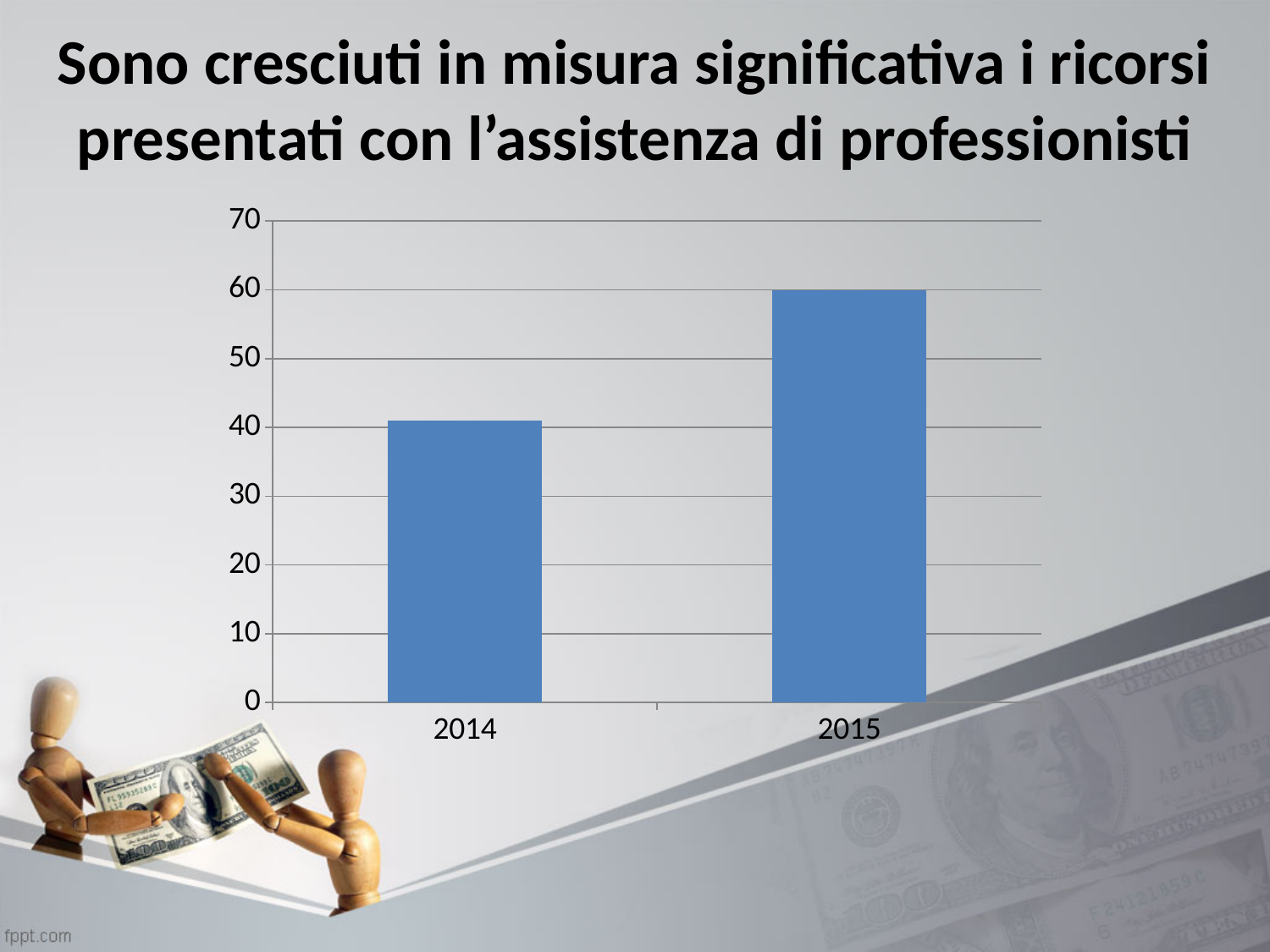
Which year has the lowest bar? 2014 Is the value for 2015 greater or less than 50? greater What is the value for 2015? 60 What is the title of the slide containing the chart? Sono cresciuti in misura significativa i ricorsi presentati con l'assistenza di professionisti How many categories are plotted on the x axis? 2 What is the maximum value shown on the vertical axis? 70 Do the values rise or fall from 2014 to 2015? rise Which is larger, the value for 2014 or the value for 2015? 2015 What kind of chart is shown on the slide? bar chart Which year has the highest bar? 2015 Is the value for 2014 greater or less than 50? less